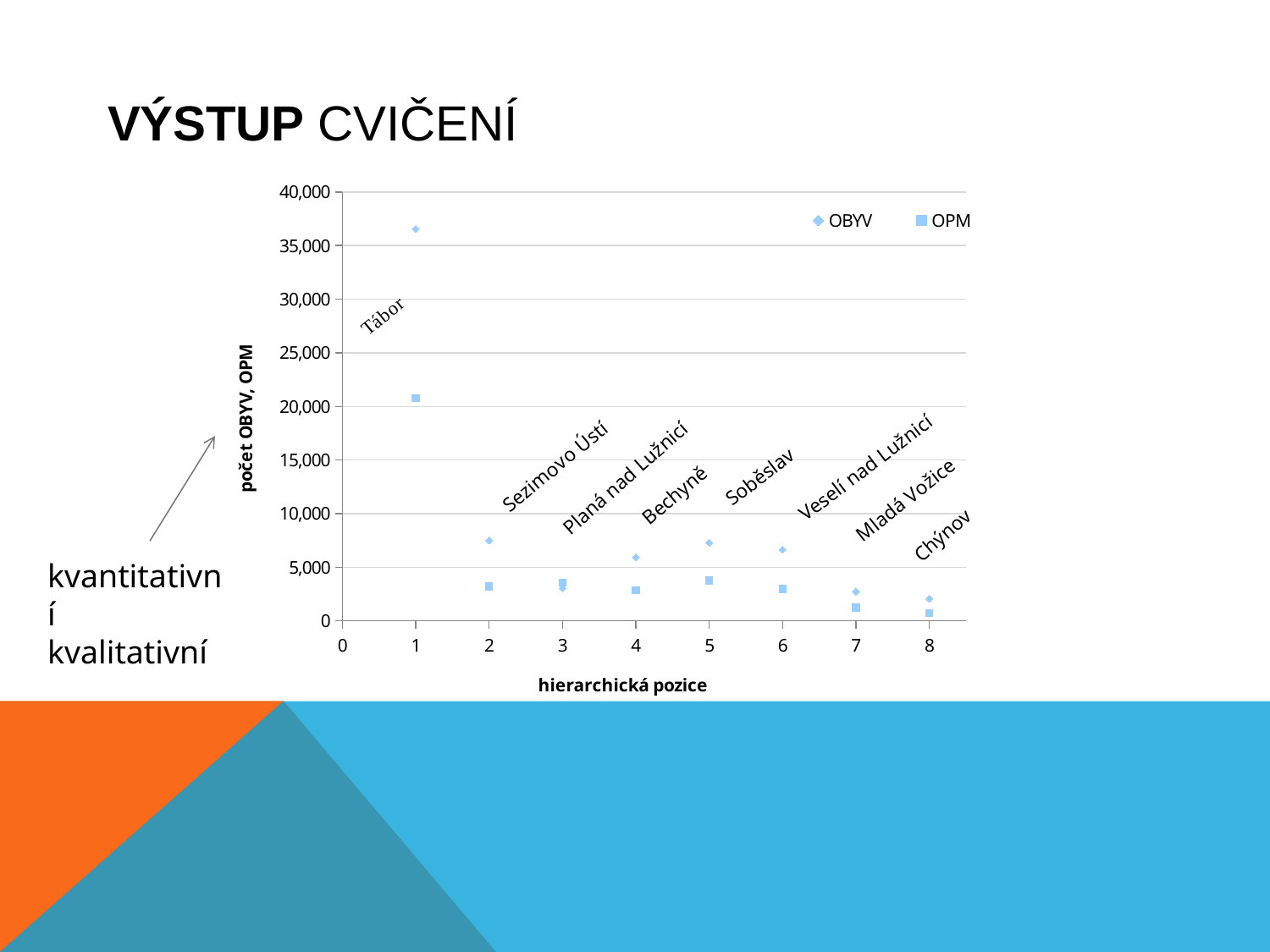
At hierarchical position 5, which series has the larger value, OBYV or OPM? OBYV What are the two series named in the chart legend? OBYV and OPM How many data points does the OBYV series have? 8 Is the OPM value at hierarchical position 1 greater or less than 15,000? greater At which hierarchical position is the OBYV value highest? 1 Is the OBYV value at hierarchical position 1 greater or less than 35,000? greater Do the OBYV values generally rise or fall as the hierarchical position increases? fall At which hierarchical position is the OPM value lowest? 8 Is the OBYV value at hierarchical position 8 greater or less than 5,000? less What kind of chart is shown on the slide? Scatter chart What is the title of the horizontal axis of the chart? hierarchická pozice How many series does the chart legend list? 2